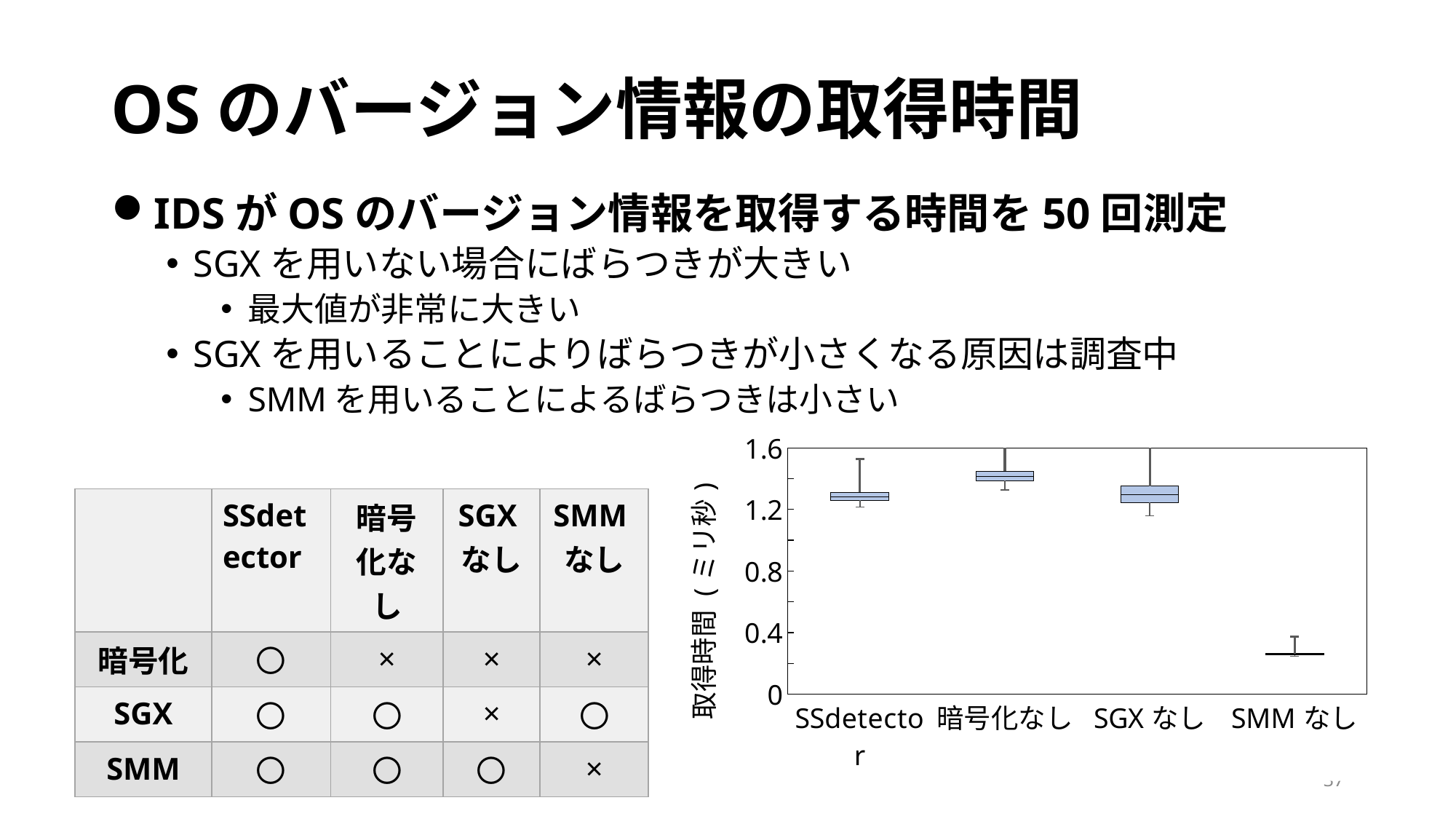
Which has the larger acquisition time, 暗号化なし or SMM なし? 暗号化なし Is the median value for SGX なし greater or less than 0.8? greater Which category has the lowest acquisition time in the chart? SMM なし What kind of chart is shown on the slide? box plot Is the median value for SSdetector greater or less than 1.2? greater Is the median value for 暗号化なし greater or less than 1.6? less Which has the larger acquisition time, SSdetector or SMM なし? SSdetector What is the label of the y axis of the chart? 取得時間（ミリ秒） Which category has the highest median acquisition time in the chart? 暗号化なし What is the highest tick value shown on the y axis of the chart? 1.6 How many categories are plotted on the x axis of the chart? 4